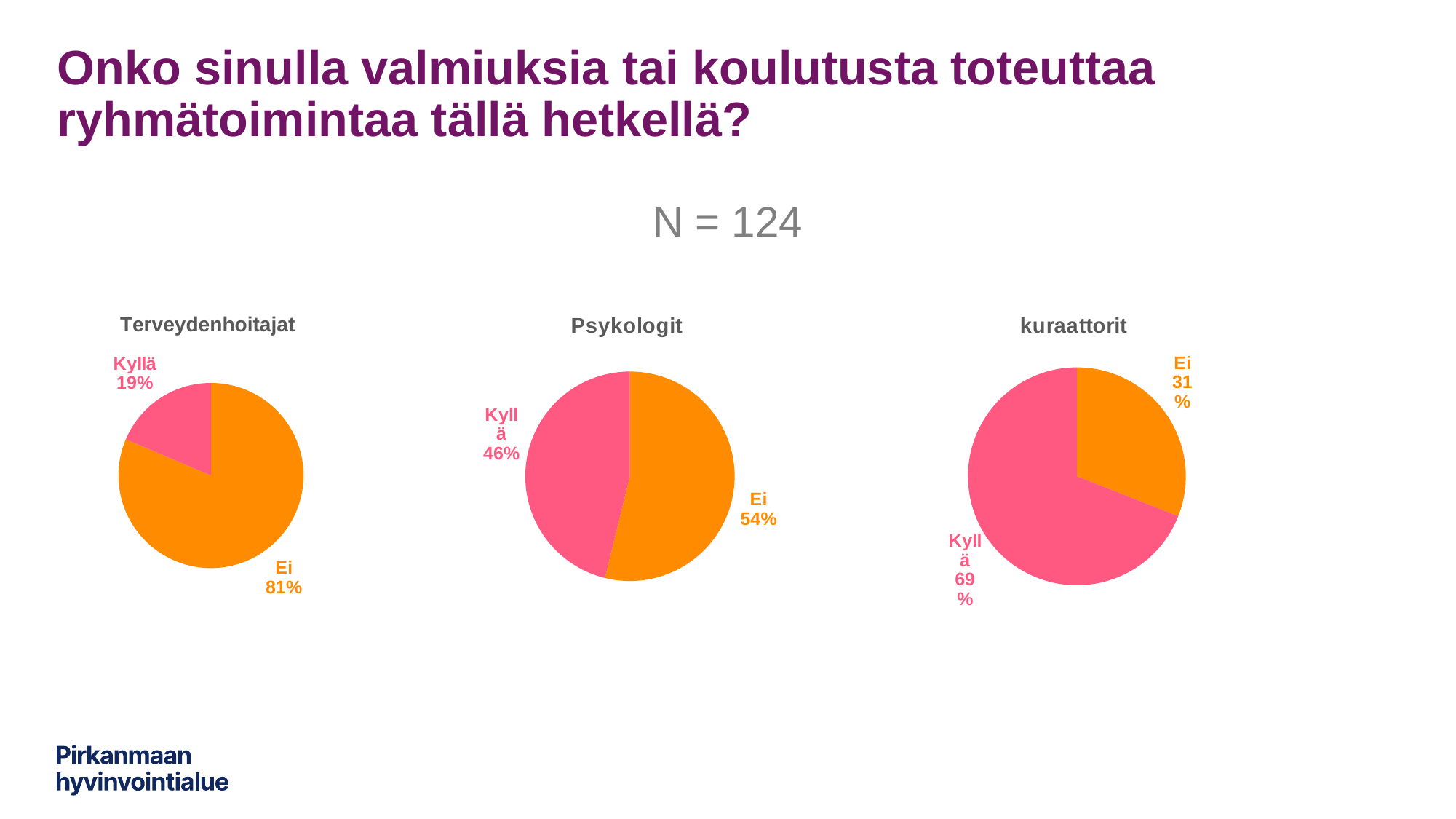
In the Psykologit chart, what share of the pie is Kyllä? 46% In the kuraattorit chart, what share of the pie is Ei? 31% What kind of chart is the Psykologit chart? Pie chart In the kuraattorit chart, which slice is the smallest? Ei In the Terveydenhoitajat chart, which slice is the largest? Ei In the Psykologit chart, which is larger, Kyllä or Ei? Ei How many slices does the kuraattorit chart have? 2 In the Terveydenhoitajat chart, what is the difference between the Ei and Kyllä shares? 62% In the Psykologit chart, what share of the pie is Ei? 54%